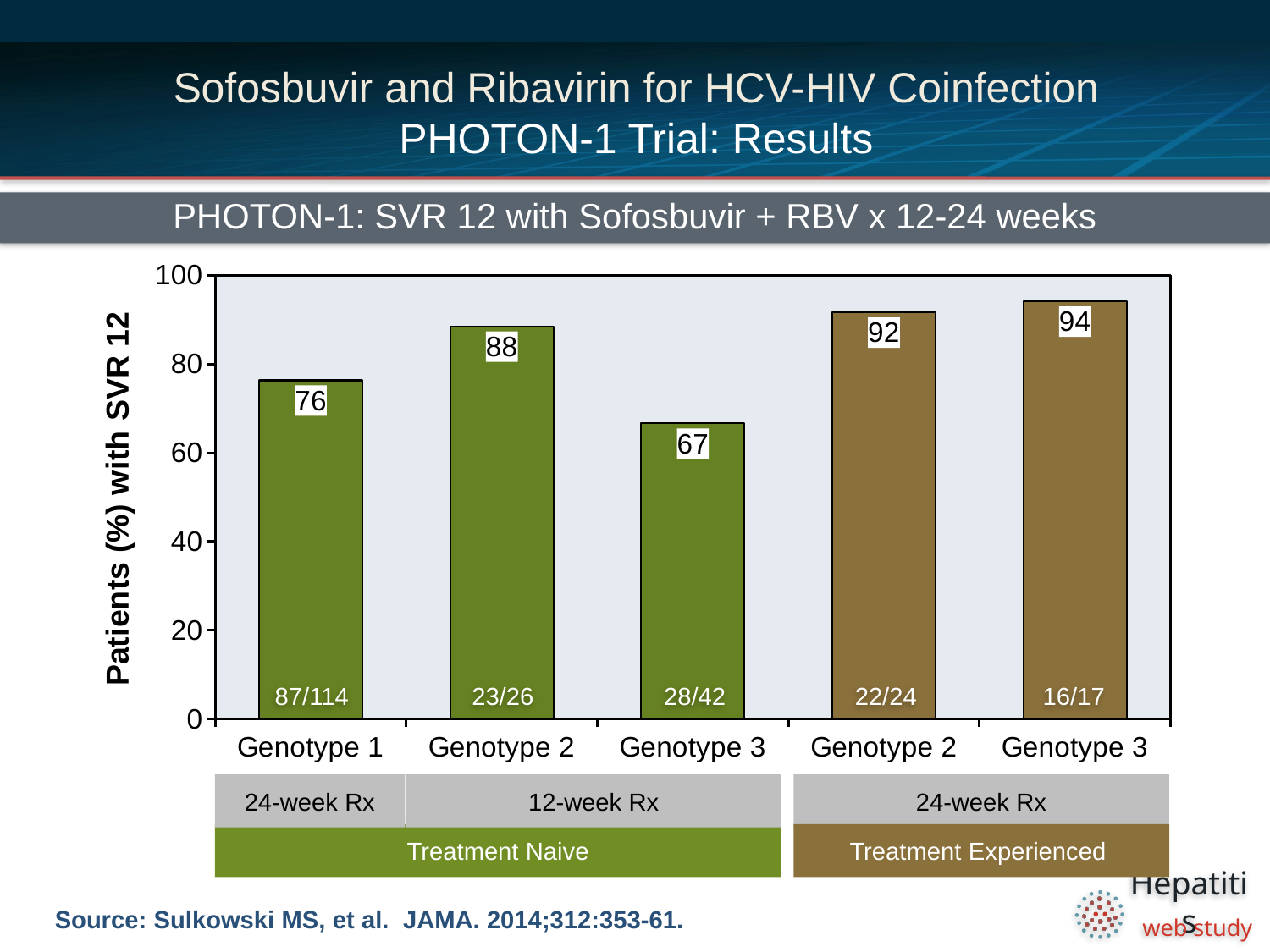
What type of chart is shown on the slide? Bar chart How many bars are shown in the chart? 5 What is the SVR 12 rate for Genotype 3 in the treatment-experienced group? 94 What is the label of the y-axis? Patients (%) with SVR 12 What is the SVR 12 rate for Genotype 2 in the treatment-naive 12-week group? 88 What treatment duration is shown for the treatment-experienced group? 24-week Rx What is the SVR 12 rate for Genotype 1 in the treatment-naive group? 76 What is the difference in SVR 12 rate between treatment-experienced Genotype 2 and treatment-naive Genotype 2? 4 Which bar has the lowest SVR 12 rate? Genotype 3 (Treatment Naive) What fraction of patients is shown for the treatment-naive Genotype 3 bar? 28/42 Which bar has the highest SVR 12 rate? Genotype 3 (Treatment Experienced) Which has a higher SVR 12 rate: treatment-naive Genotype 1 or treatment-naive Genotype 3? Genotype 1